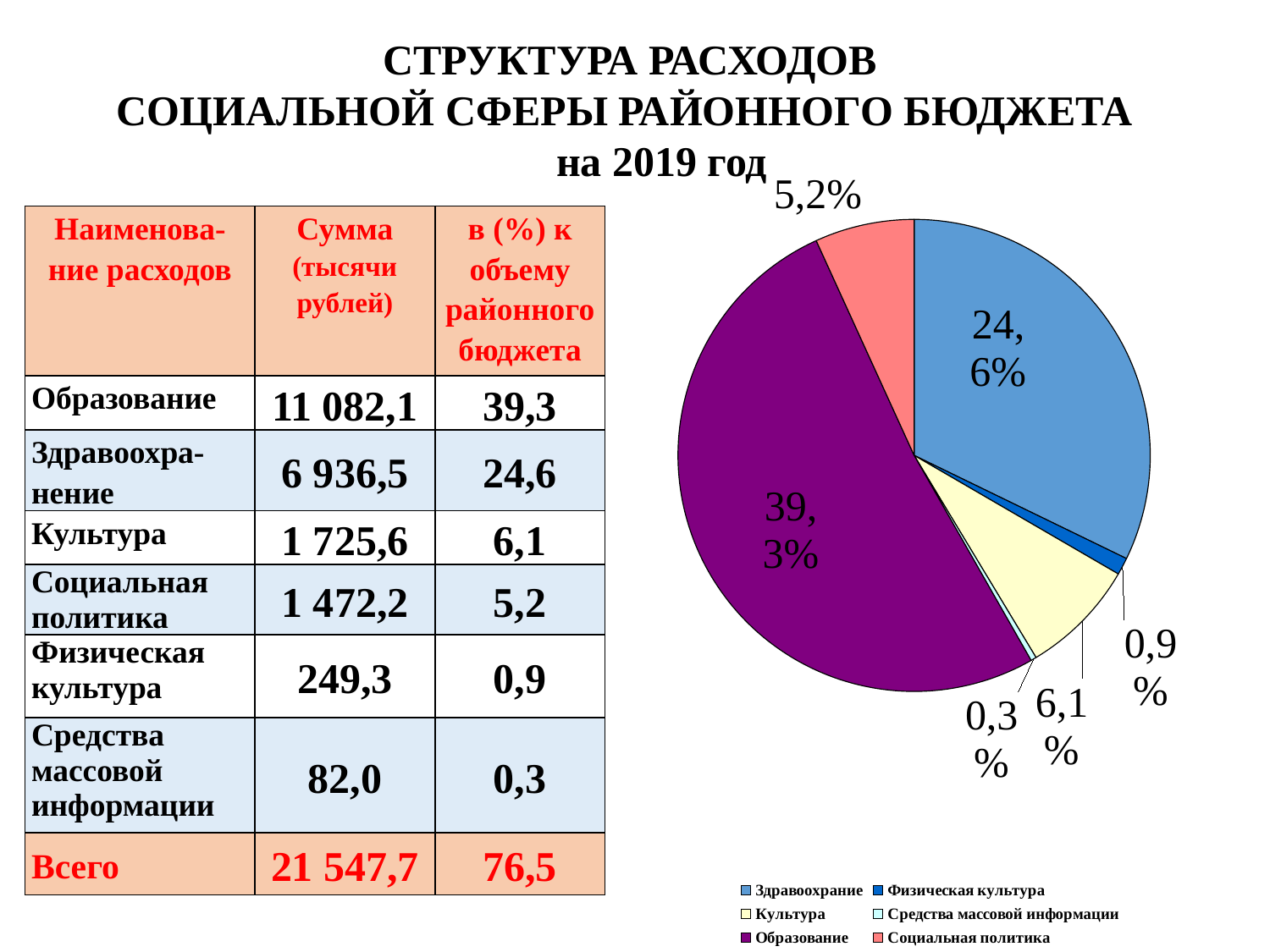
What is the difference in percentage points between the Образование and Здравоохранение slices? 14,7 What share of the pie does Здравоохранение have? 24,6% Which slice is larger: Культура or Социальная политика? Культура Which category has the largest slice of the pie? Образование How many slices does the pie chart have? 6 What share of the pie does Образование have? 39,3% What share of the pie does Социальная политика have? 5,2% Which category has the smallest slice of the pie? Средства массовой информации How many entries does the pie chart's legend list? 6 What kind of chart is shown on the slide? pie chart